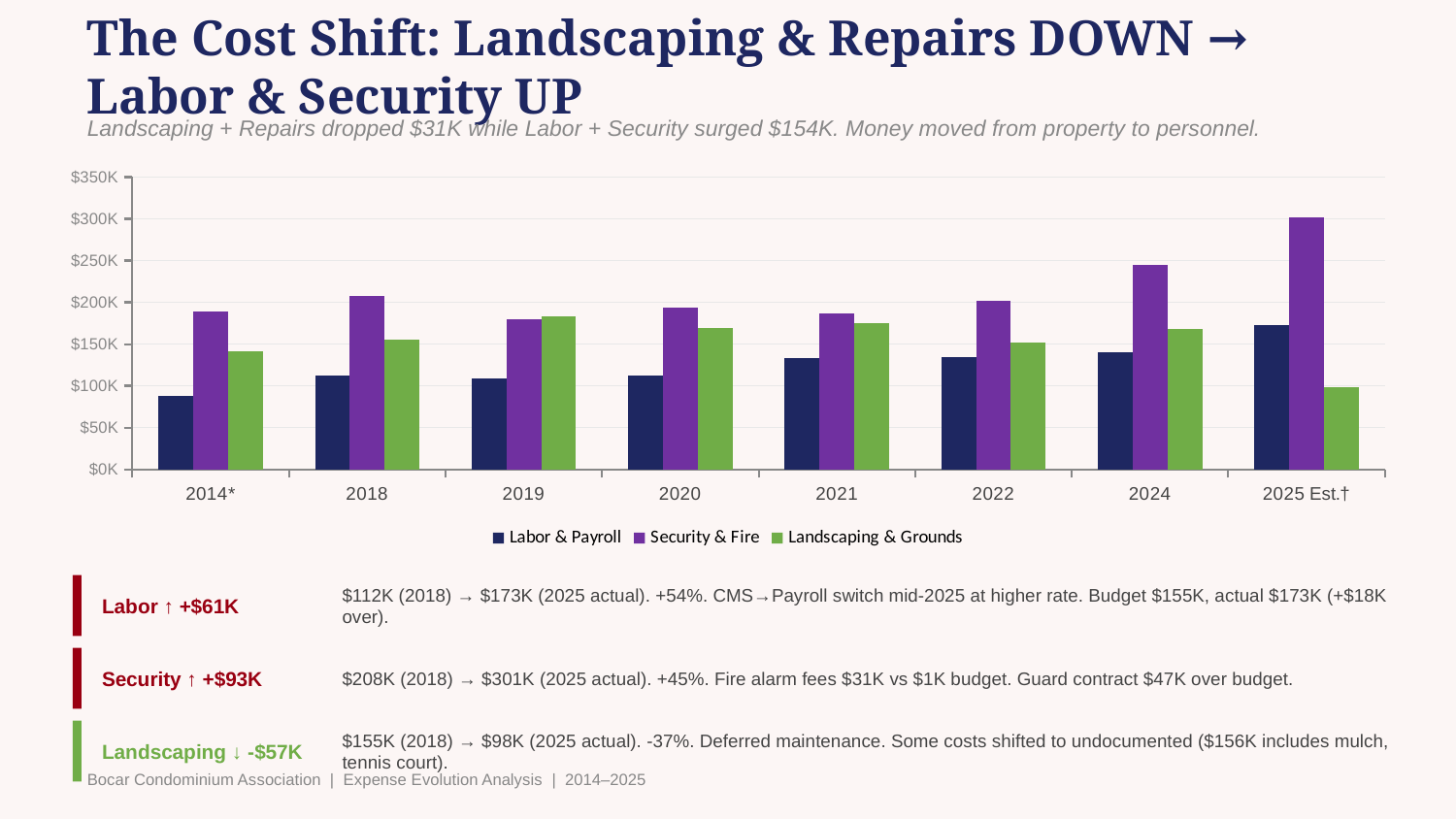
Is the Landscaping & Grounds value for 2025 Est.† greater or less than $150K? less Which colour represents Landscaping & Grounds in the chart? green How many series does the chart legend list? 3 How many year categories are shown on the x axis of the chart? 8 In 2020, which is larger: Security & Fire or Landscaping & Grounds? Security & Fire In which year is the Landscaping & Grounds bar the lowest? 2025 Est.† Is the Labor & Payroll value for 2014* greater or less than $100K? less Is the Security & Fire value for 2024 greater or less than $200K? greater What kind of chart is shown on the slide? bar chart In which year is the Labor & Payroll bar the lowest? 2014* Does the Labor & Payroll series generally rise or fall from 2014* to 2025 Est.†? rise In which year is the Security & Fire bar the highest? 2025 Est.†